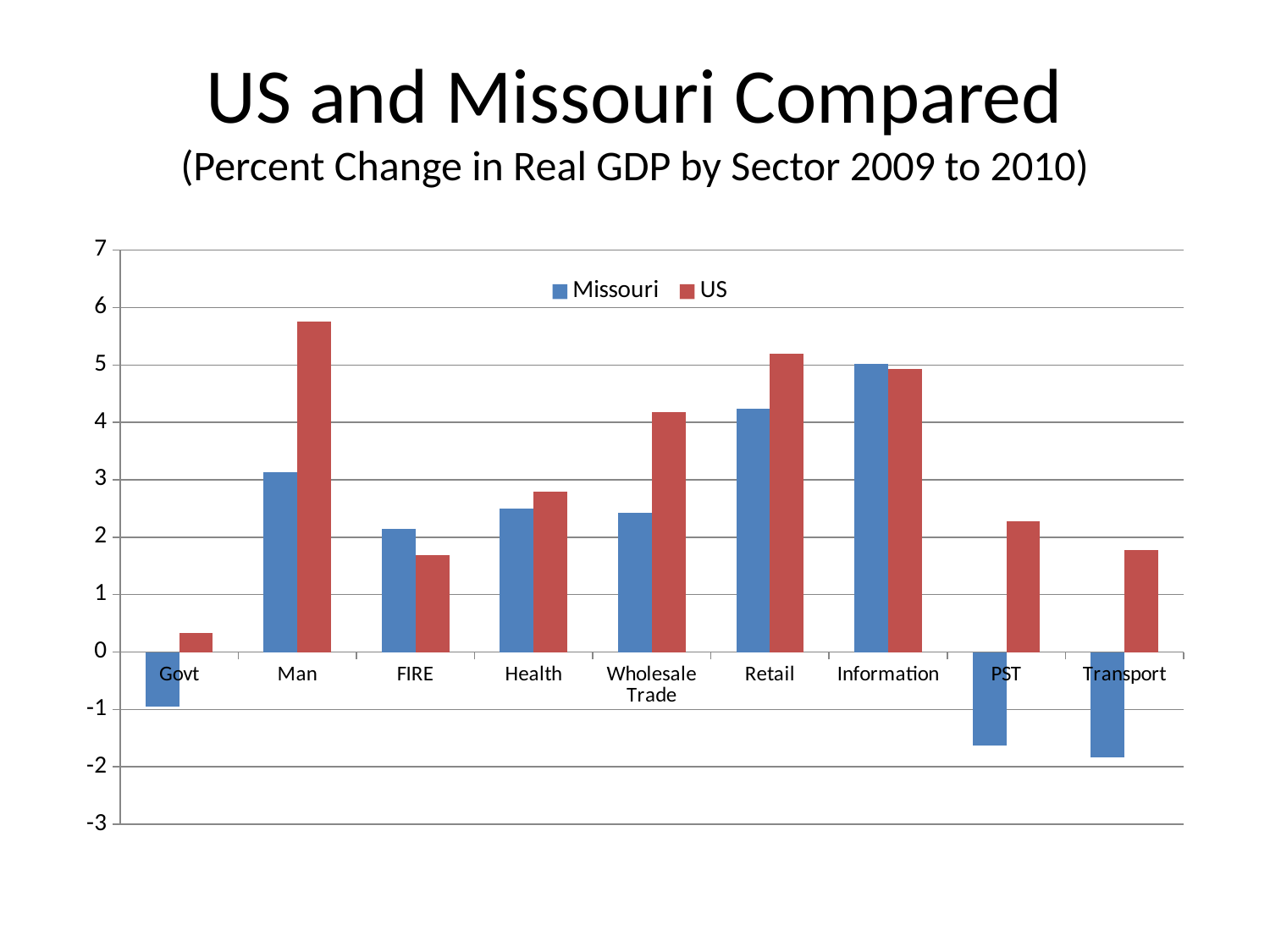
What kind of chart is shown on the slide? bar chart Is the Missouri value for Retail greater or less than 4? greater For the FIRE sector, which is larger, the Missouri value or the US value? Missouri Is the US value for Man greater or less than 5? greater Which sector has the lowest value for US? Govt What colour are the bars for the Missouri series? blue Which sector has the highest value for US? Man How many sectors are shown on the x axis? 9 Which sector has the highest value for Missouri? Information Is the Missouri value for PST greater or less than -1? less For the Man sector, which is larger, the Missouri value or the US value? US How many series does the legend list? 2